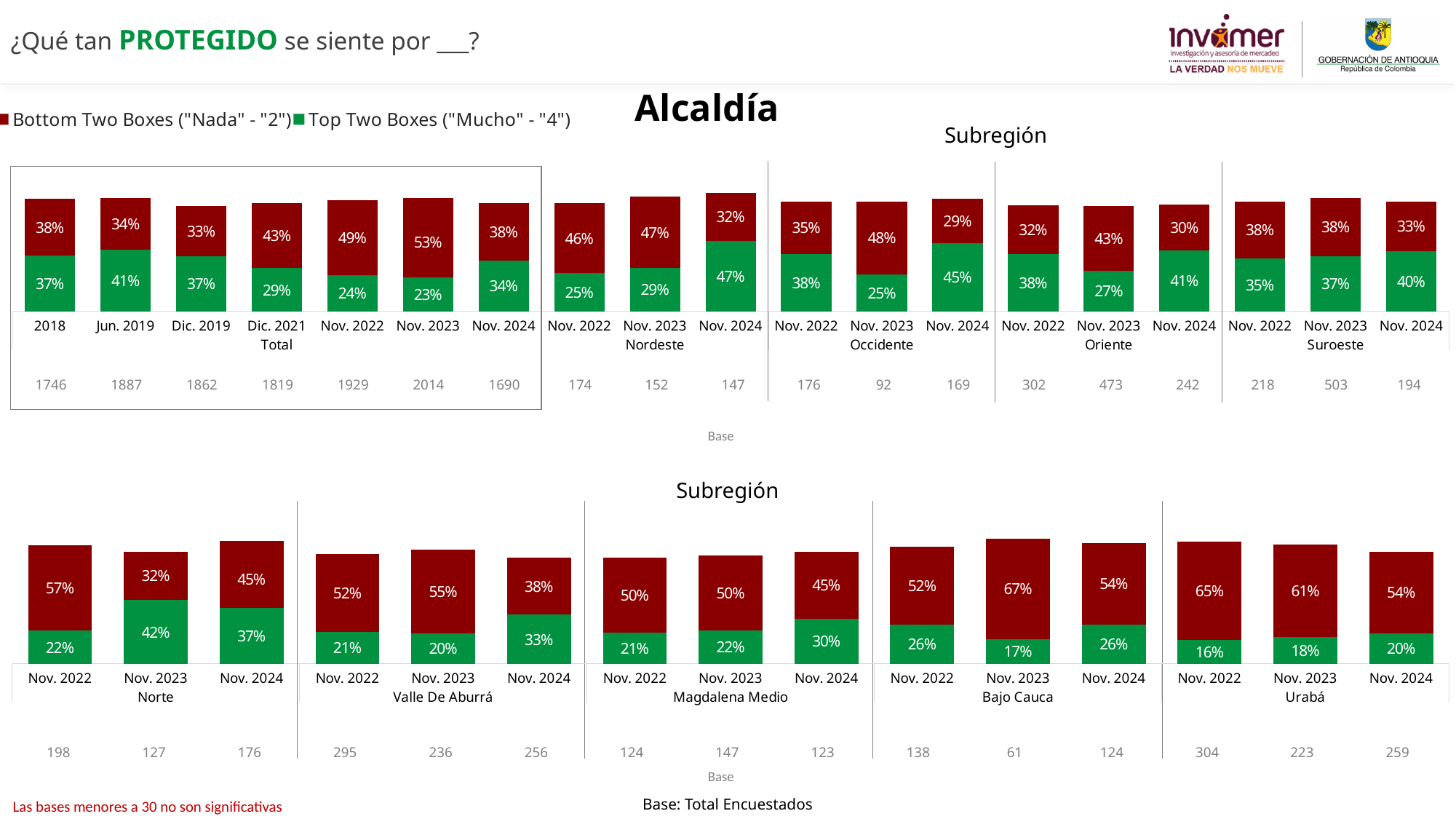
How many series does the legend list? 2 Which colour represents the Top Two Boxes series in the legend? green In the bottom chart, how does the Top Two Boxes value for Magdalena Medio change from Nov. 2022 to Nov. 2024? rises In the bottom chart, what is the Bottom Two Boxes value for Bajo Cauca in Nov. 2023? 67% In the top chart, what is the Bottom Two Boxes value for Nordeste in Nov. 2023? 47% What kind of chart is shown on the slide? stacked bar chart In the top chart, which Total period has the highest Bottom Two Boxes value? Nov. 2023 In the top chart, what is the difference between the Bottom Two Boxes and Top Two Boxes values for Total in Nov. 2023? 30 percentage points In the bottom chart, which Nov. 2024 subregion has the lowest Top Two Boxes value? Urabá In the top chart, what is the Top Two Boxes value for Total in Nov. 2024? 34% In the bottom chart, is the Top Two Boxes value for Norte in Nov. 2023 larger or smaller than that for Valle De Aburrá in Nov. 2023? larger In the top chart, what is the combined total of the Bottom Two Boxes and Top Two Boxes values for Nordeste in Nov. 2024? 79%